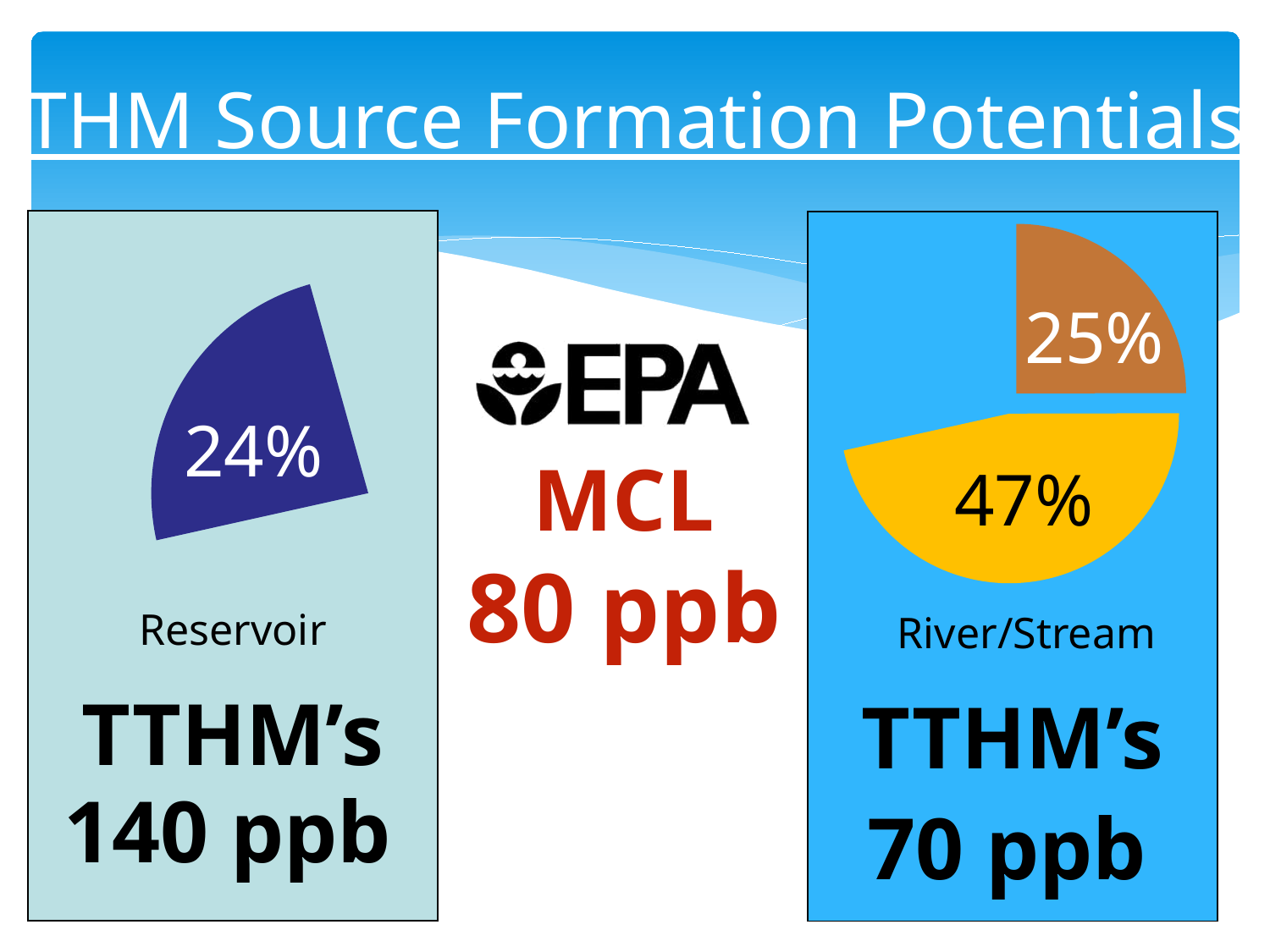
What MCL value is printed between the two charts? 80 ppb What TTHM's value is printed below the Reservoir chart on the left? 140 ppb In the Reservoir chart on the left, what percentage is shown on the blue slice? 24% How many labelled slices are shown in the Reservoir chart on the left? 1 How many labelled slices are shown in the River/Stream chart on the right? 2 In the River/Stream chart on the right, what is the difference between the yellow slice and the brown slice? 22 percentage points In the River/Stream chart on the right, is the yellow slice or the brown slice larger? the yellow slice In the River/Stream chart on the right, what percentage is shown on the brown slice? 25% In the River/Stream chart on the right, which slice has the smallest share? the brown slice (25%) What kind of chart is shown in the Reservoir panel on the left? pie chart In the River/Stream chart on the right, which slice has the largest share? the yellow slice (47%) In the River/Stream chart on the right, what percentage is shown on the yellow slice? 47%